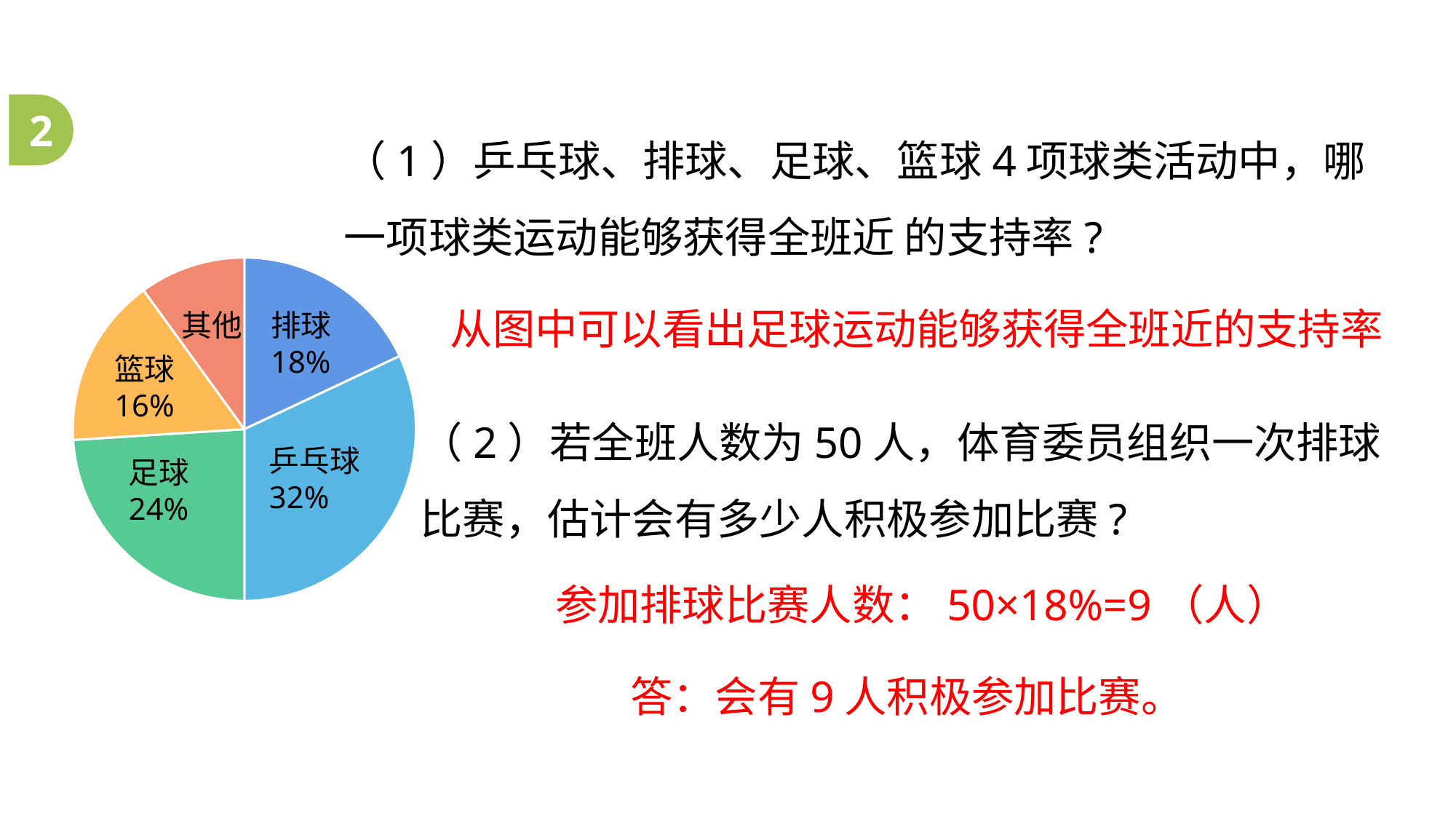
What type of chart is shown on the slide? pie chart What percentage is shown for 排球 in the pie chart? 18% What is the combined percentage of 乒乓球, 排球, 足球 and 篮球 in the pie chart? 90% What is the difference in percentage points between 乒乓球 and 排球 in the pie chart? 14% How many slices does the pie chart have? 5 What percentage of the pie chart is labelled for 乒乓球? 32% Which has a larger share in the pie chart, 足球 or 篮球? 足球 What percentage is shown for 足球 in the pie chart? 24% Among the four ball sports labelled with percentages (乒乓球, 排球, 足球, 篮球), which has the smallest share? 篮球 What colour is the 足球 slice in the pie chart? green What percentage is shown for 篮球 in the pie chart? 16% Which slice of the pie chart has the largest share? 乒乓球